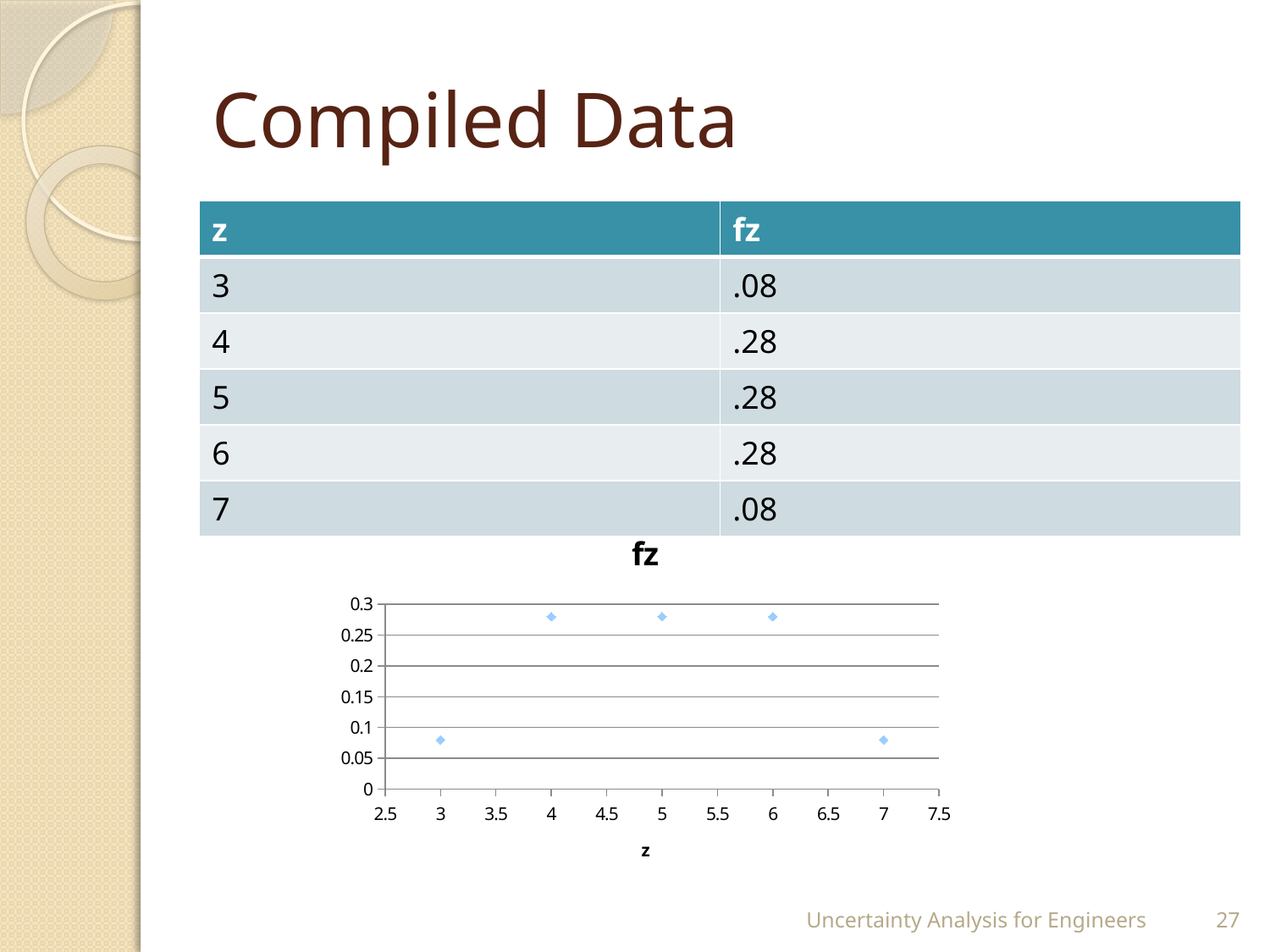
Is the value of fz at z = 3 greater or less than 0.1? less How many data points are plotted in the chart? 5 What kind of chart is shown on the slide? scatter chart What is the title of the chart? fz Which has the larger fz value, z = 4 or z = 7? z = 4 What is the difference between the fz value at z = 4 and the fz value at z = 3? .20 Is the value of fz at z = 6 greater or less than 0.25? greater What is the value of fz at z = 7? .08 What is the value of fz at z = 3? .08 What is the label on the x axis of the chart? z Do the fz values rise or fall from z = 6 to z = 7? fall What is the value of fz at z = 5? .28